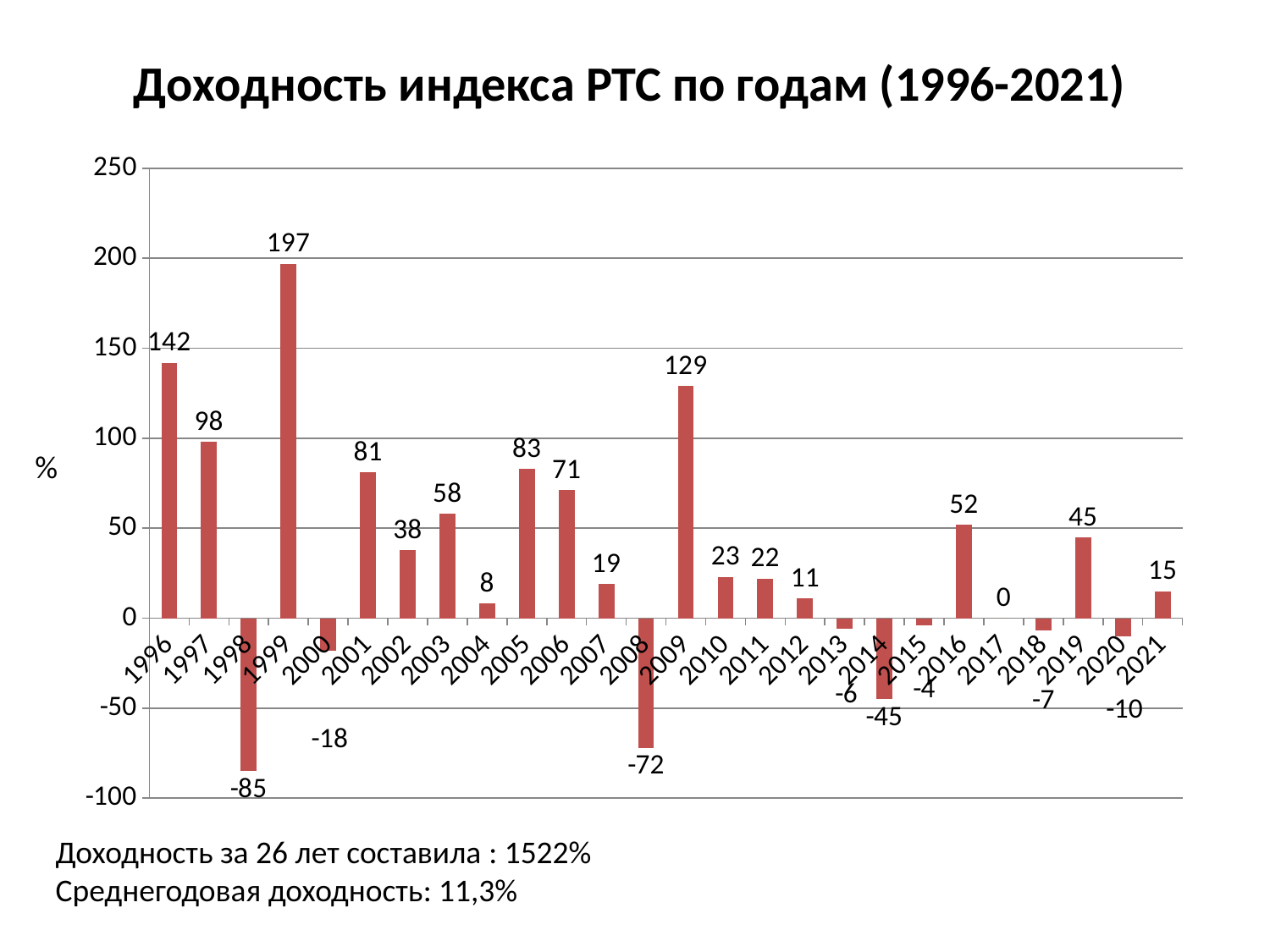
Is the value for 2009 greater or less than 100? greater Which is larger, the value for 2005 or the value for 2006? 2005 How many years are shown on the x axis? 26 Which year has the lowest value? 1998 What is the value for 1999? 197 What is the label on the vertical axis? % What is the difference between the values for 1996 and 1997? 44 What is the title of the chart? Доходность индекса РТС по годам (1996-2021) Which year has the highest value? 1999 What kind of chart is shown on the slide? bar chart What is the value for 2017? 0 What is the value for 2008? -72